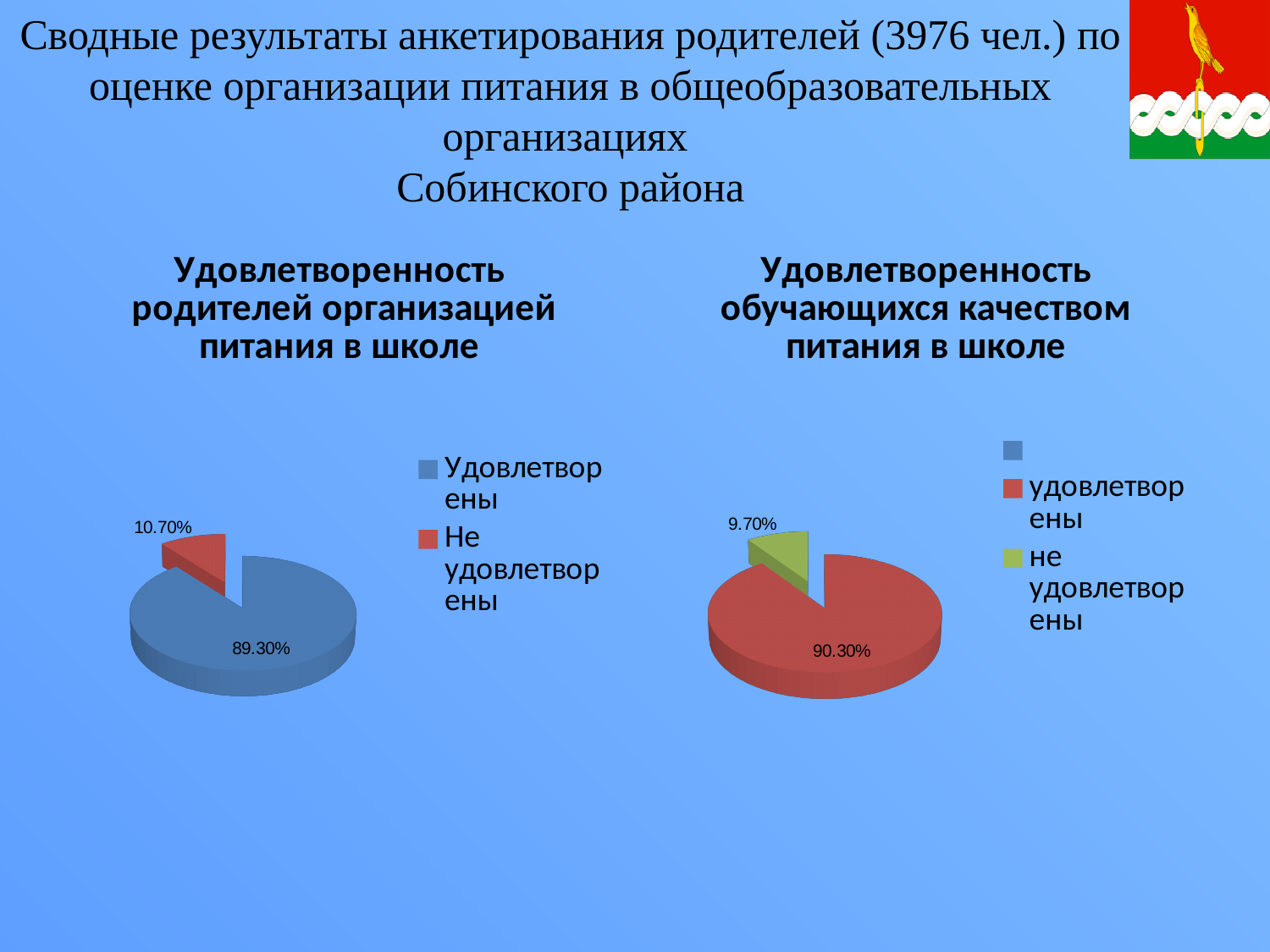
In the left chart 'Удовлетворенность родителей организацией питания в школе', what share is labelled for 'Не удовлетворены'? 10.70% In the left chart 'Удовлетворенность родителей организацией питания в школе', what is the difference between the 'Удовлетворены' and 'Не удовлетворены' shares? 78.60% What type of chart is the left chart 'Удовлетворенность родителей организацией питания в школе'? pie chart In the right chart 'Удовлетворенность обучающихся качеством питания в школе', which category has the smallest slice? не удовлетворены In the left chart 'Удовлетворенность родителей организацией питания в школе', what colour is the 'Не удовлетворены' slice? red Which is larger: the 'Удовлетворены' share in the left chart or the 'удовлетворены' share in the right chart? the right chart (90.30%) In the right chart 'Удовлетворенность обучающихся качеством питания в школе', what is the difference between the 'удовлетворены' and 'не удовлетворены' shares? 80.60% In the right chart 'Удовлетворенность обучающихся качеством питания в школе', what share is labelled for 'удовлетворены'? 90.30% In the left chart 'Удовлетворенность родителей организацией питания в школе', what share is labelled for 'Удовлетворены'? 89.30% In the left chart 'Удовлетворенность родителей организацией питания в школе', which category has the largest slice? Удовлетворены In the right chart 'Удовлетворенность обучающихся качеством питания в школе', what share is labelled for 'не удовлетворены'? 9.70% How many slices does the right chart 'Удовлетворенность обучающихся качеством питания в школе' have? 2